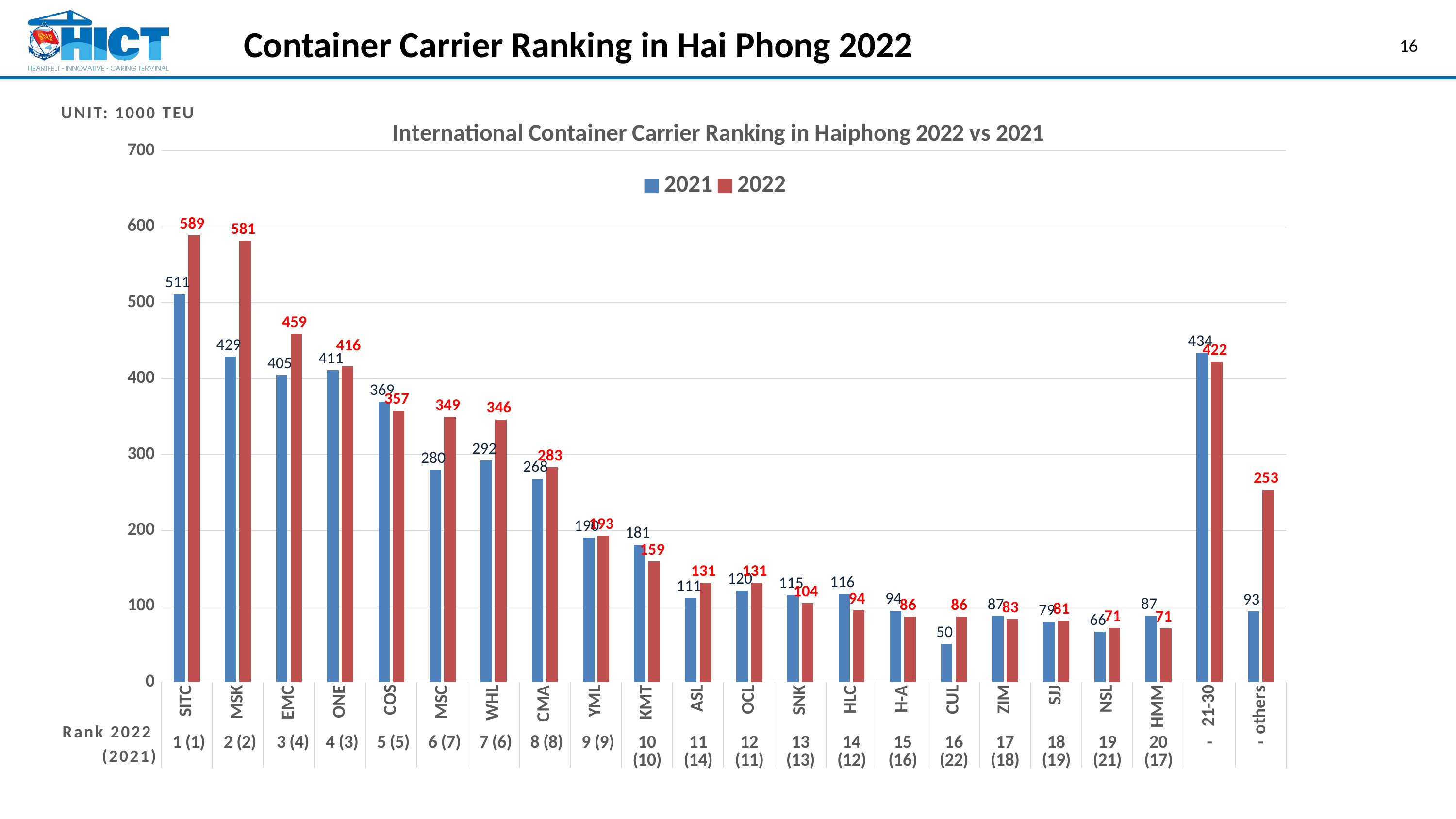
What is the 2022 value for the 'others' category? 253 What is the 2022 value for KMT? 159 By how much did SITC's value increase from 2021 to 2022? 78 Which has the larger 2022 value, EMC or ONE? EMC How many series does the legend list? 2 What is the 2022 value for SITC? 589 What kind of chart is shown on the slide? Bar chart What unit is stated for the chart values? 1000 TEU Which carrier has the lowest 2021 value? CUL Which carrier has the highest 2022 value? SITC How many categories are shown on the x axis? 22 What is the 2021 value for MSK? 429